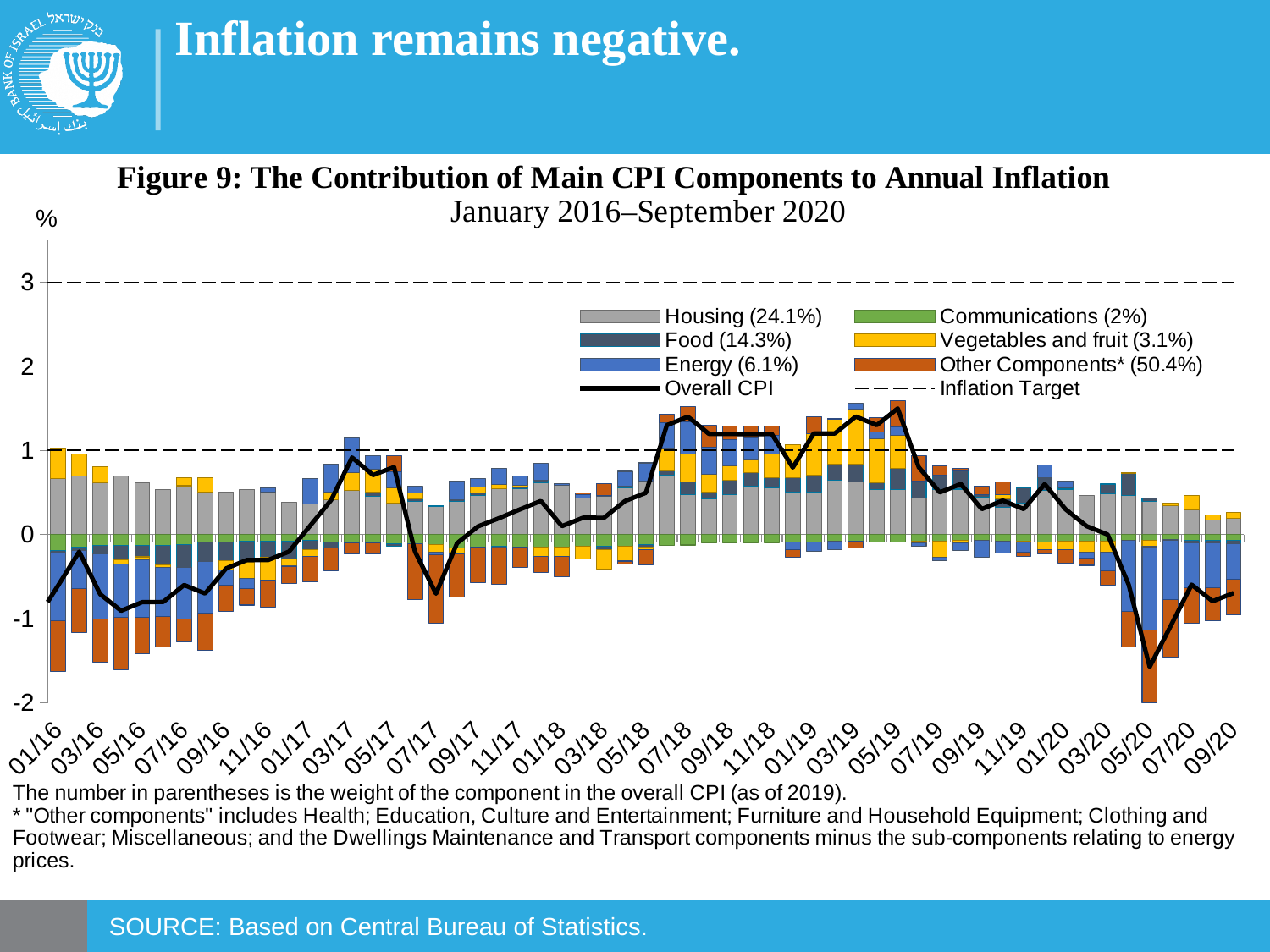
Is the Overall CPI value for 05/20 greater or less than -1? less In which month does the Overall CPI line reach its lowest value? 05/20 Which is higher, the Overall CPI value for 07/17 or for 07/18? 07/18 What is the title of the figure on the slide? Figure 9: The Contribution of Main CPI Components to Annual Inflation Is the Overall CPI value for 09/20 greater or less than 0? less Does the Overall CPI line rise or fall between 01/20 and 05/20? fall According to the legend, what is the weight of Housing in the overall CPI? 24.1% Is the Overall CPI value for 07/18 greater or less than 1? greater Does the Overall CPI line rise or fall between 01/16 and 03/17? rise What kind of chart is shown on the slide? combination bar and line chart How many entries does the chart's legend list? 8